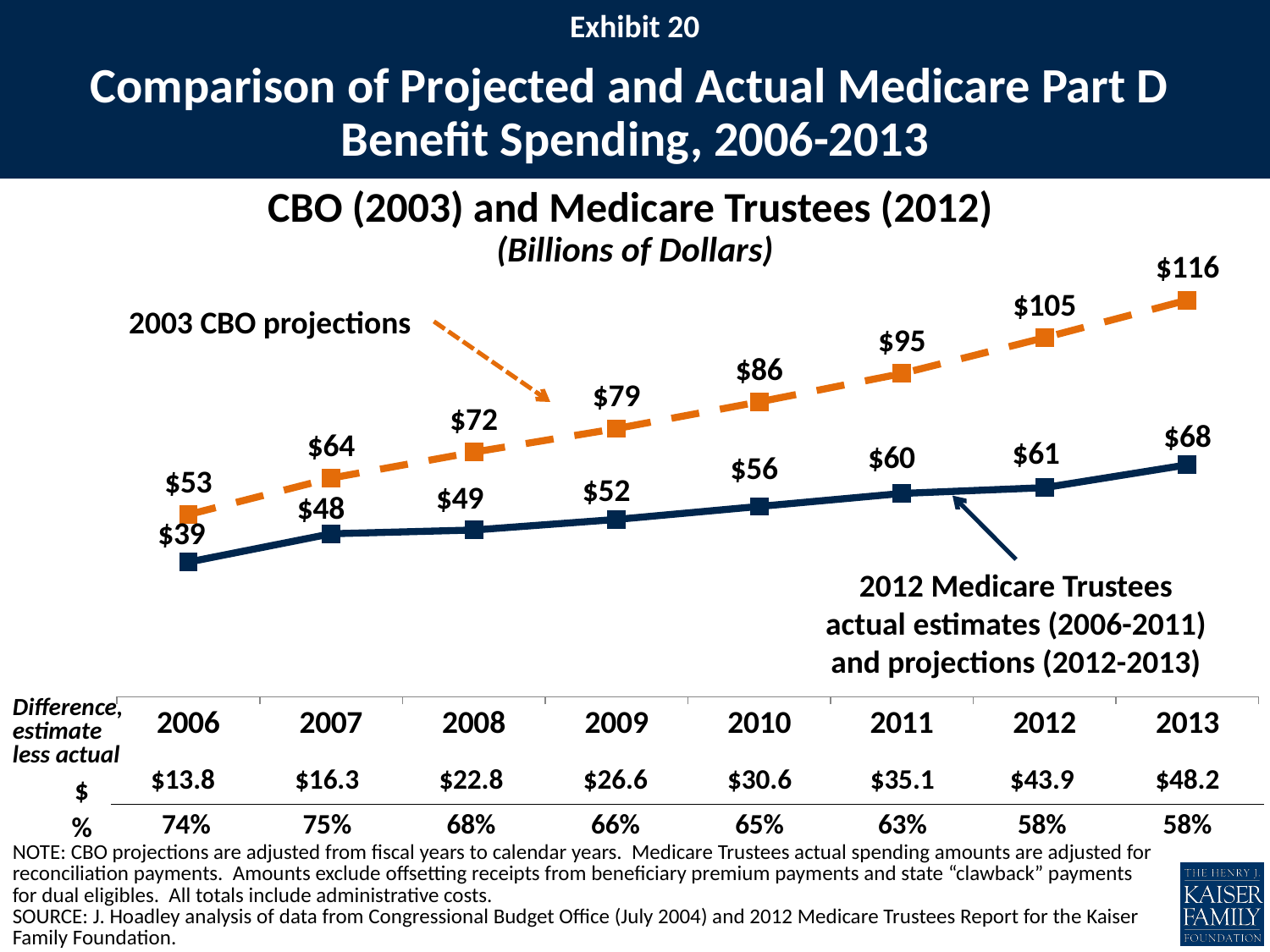
What is the 2012 Medicare Trustees value for 2011? $60 How many years are plotted on the chart? 8 How much higher is the 2003 CBO projection for 2013 than for 2006? $63 What is the 2003 CBO projection for 2013? $116 What is the 2003 CBO projection for 2009? $79 According to the table below the chart, what is the percentage difference (estimate less actual) for 2008? 68% In which year is the 2003 CBO projection highest? 2013 Which is larger in 2010, the 2003 CBO projection or the 2012 Medicare Trustees value? 2003 CBO projection What kind of chart is shown on the slide? line chart How many data series are plotted on the chart? 2 In which year is the 2012 Medicare Trustees value lowest? 2006 Do the 2012 Medicare Trustees values rise or fall from 2006 to 2013? rise